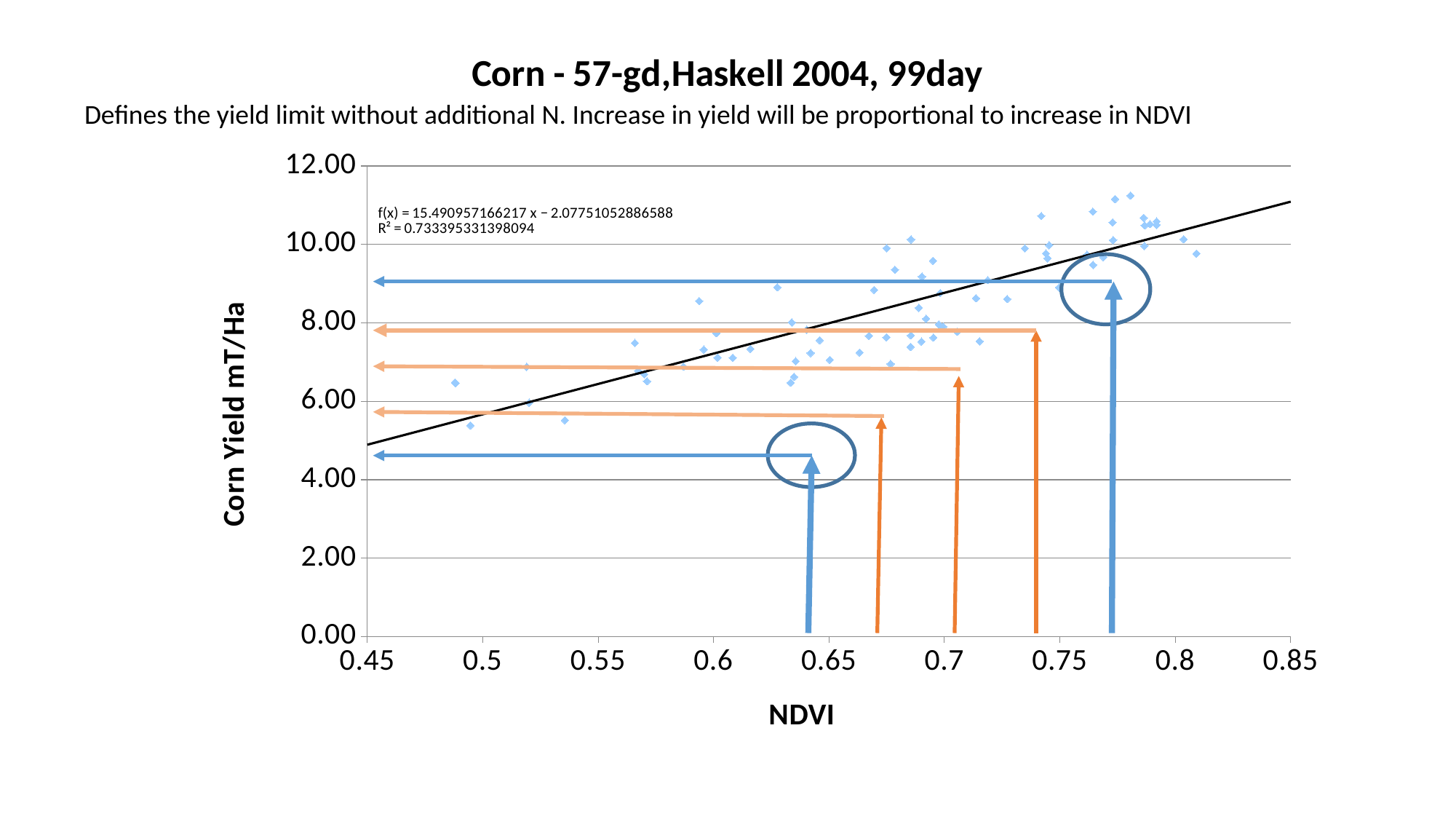
What is the slope of the fitted line f(x) printed on the chart? 15.490957166217 What kind of chart is shown on the slide? scatter chart What is the highest tick value shown on the NDVI axis? 0.85 What is the label of the vertical axis? Corn Yield mT/Ha What R² value is printed on the chart for the trendline? 0.733395331398094 What is the highest tick value shown on the vertical axis? 12.00 Does corn yield rise or fall as NDVI increases along the x axis? rise What is the title of the chart? Corn - 57-gd,Haskell 2004, 99day What is the intercept of the fitted line f(x) printed on the chart? −2.07751052886588 Is the trendline value at NDVI 0.45 greater or less than 6.00? less Is the trendline value at NDVI 0.85 greater or less than 10.00? greater